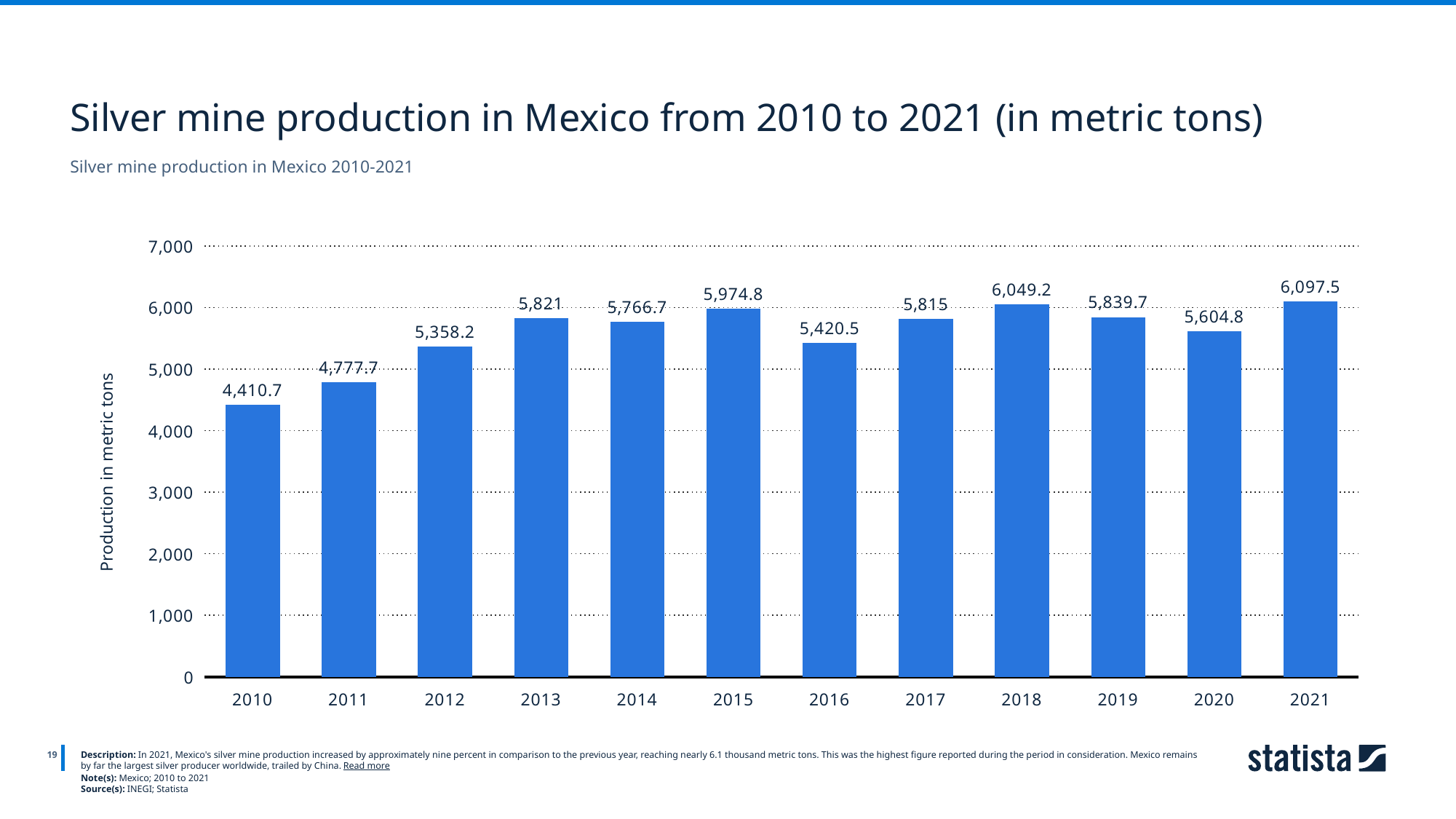
What kind of chart is shown on the slide? Bar chart Which year had higher silver mine production, 2015 or 2016? 2015 What is the difference in silver mine production between 2021 and 2020? 492.7 What was the silver mine production in Mexico in 2016? 5,420.5 What was the silver mine production in Mexico in 2020? 5,604.8 What is the label of the y axis? Production in metric tons Which year had the lowest silver mine production? 2010 How many years are shown on the chart? 12 Which year had the highest silver mine production? 2021 Did silver mine production rise or fall from 2010 to 2013? Rise What was the silver mine production in Mexico in 2010? 4,410.7 Is the value for 2012 greater or less than 5,000? greater